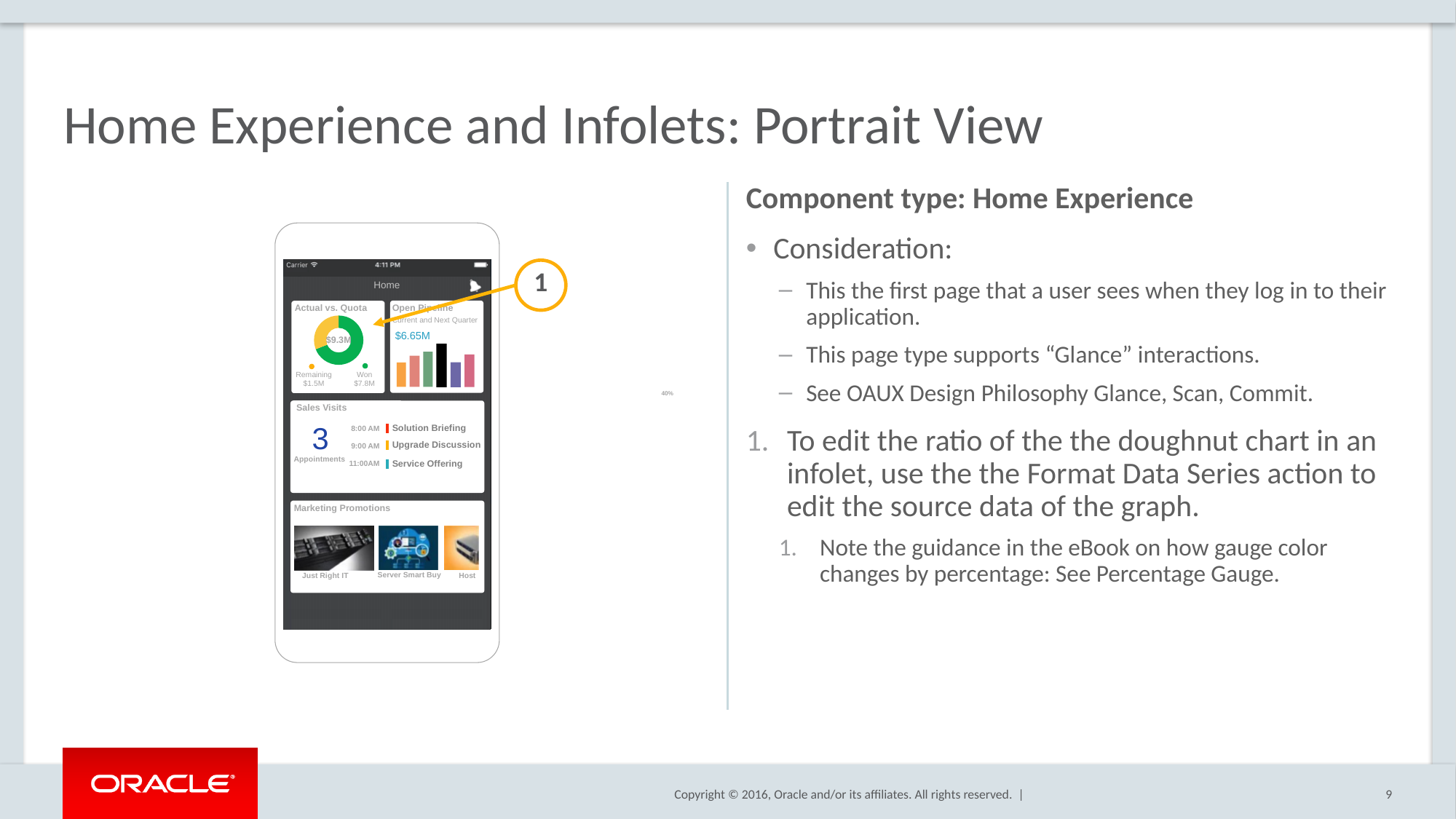
How many categories does the "Actual vs. Quota" doughnut chart show? 2 What value is printed above the bars in the "Open Pipeline" infolet? $6.65M In the "Actual vs. Quota" chart, what is the value for Won? $7.8M What kind of chart is the "Actual vs. Quota" chart on the phone screen? Doughnut chart In the "Actual vs. Quota" chart, what is the difference between Won and Remaining? $6.3M In the "Actual vs. Quota" chart, what is the value for Remaining? $1.5M What value is shown in the center of the "Actual vs. Quota" doughnut chart? $9.3M In the "Actual vs. Quota" chart, which is larger, Won or Remaining? Won In the "Actual vs. Quota" chart, which category has the lowest value? Remaining How many bars are in the "Open Pipeline" bar chart? 6 What kind of chart is shown in the "Open Pipeline" infolet? Bar chart In the "Actual vs. Quota" chart, which category has the highest value? Won